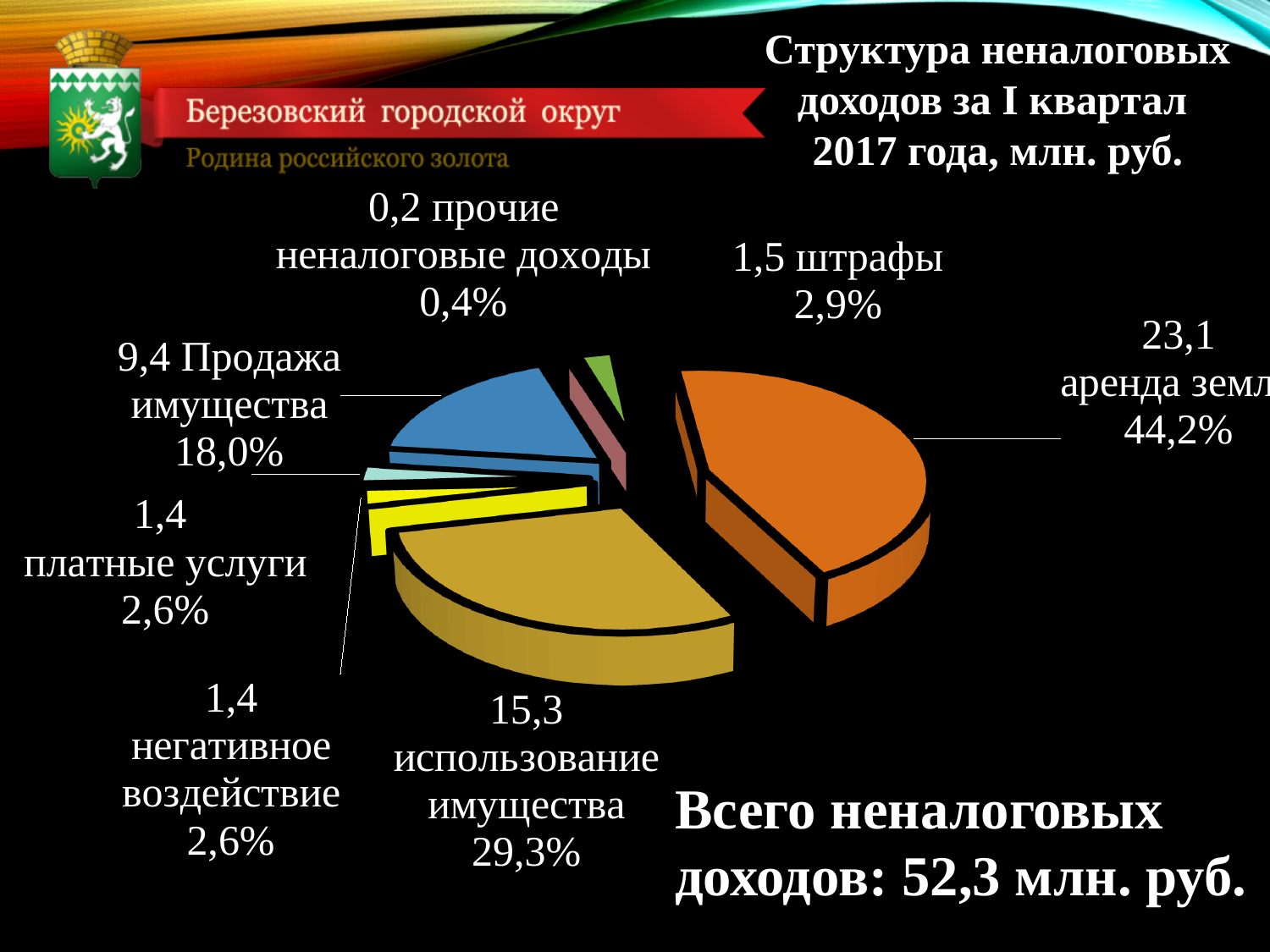
What is the total of non-tax revenues stated on the slide? 52,3 млн. руб. What is the difference between the values for "аренда земли" and "использование имущества"? 7,8 What is the value for "Продажа имущества"? 9,4 Which category has the smallest slice of the pie? прочие неналоговые доходы What share of the pie does "использование имущества" have? 29,3% What is the title of the chart? Структура неналоговых доходов за I квартал 2017 года, млн. руб. How many slices does the pie chart have? 7 What kind of chart is shown on the slide? pie chart What share of the pie does "аренда земли" have? 44,2% What is the value for "штрафы" in the pie chart? 1,5 Which is larger, the value for "Продажа имущества" or the value for "штрафы"? Продажа имущества Which category has the largest slice of the pie? аренда земли